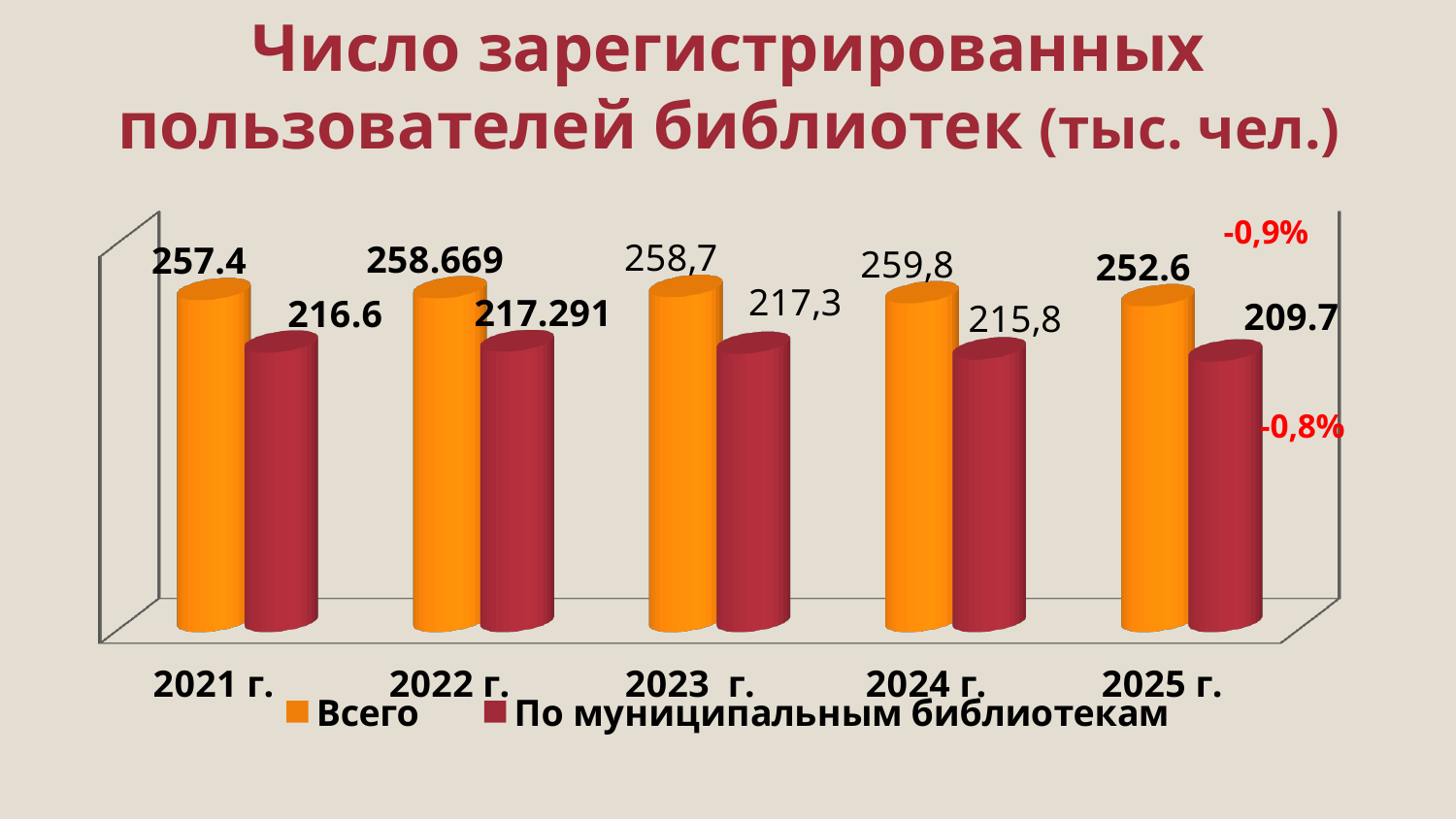
In which year is the value for "По муниципальным библиотекам" the lowest? 2025 г. What is the value for "Всего" in 2021 г.? 257.4 How many years are shown on the x axis? 5 What is the value for "Всего" in 2024 г.? 259,8 Does the value for "Всего" rise or fall from 2024 г. to 2025 г.? Fall What is the difference between "Всего" and "По муниципальным библиотекам" in 2021 г.? 40.8 What is the value for "По муниципальным библиотекам" in 2025 г.? 209.7 What kind of chart is shown on the slide? Bar chart What is the value for "По муниципальным библиотекам" in 2022 г.? 217.291 In which year is the value for "Всего" the lowest? 2025 г. Which is larger in 2023 г.: "Всего" or "По муниципальным библиотекам"? Всего How many series does the legend list? 2